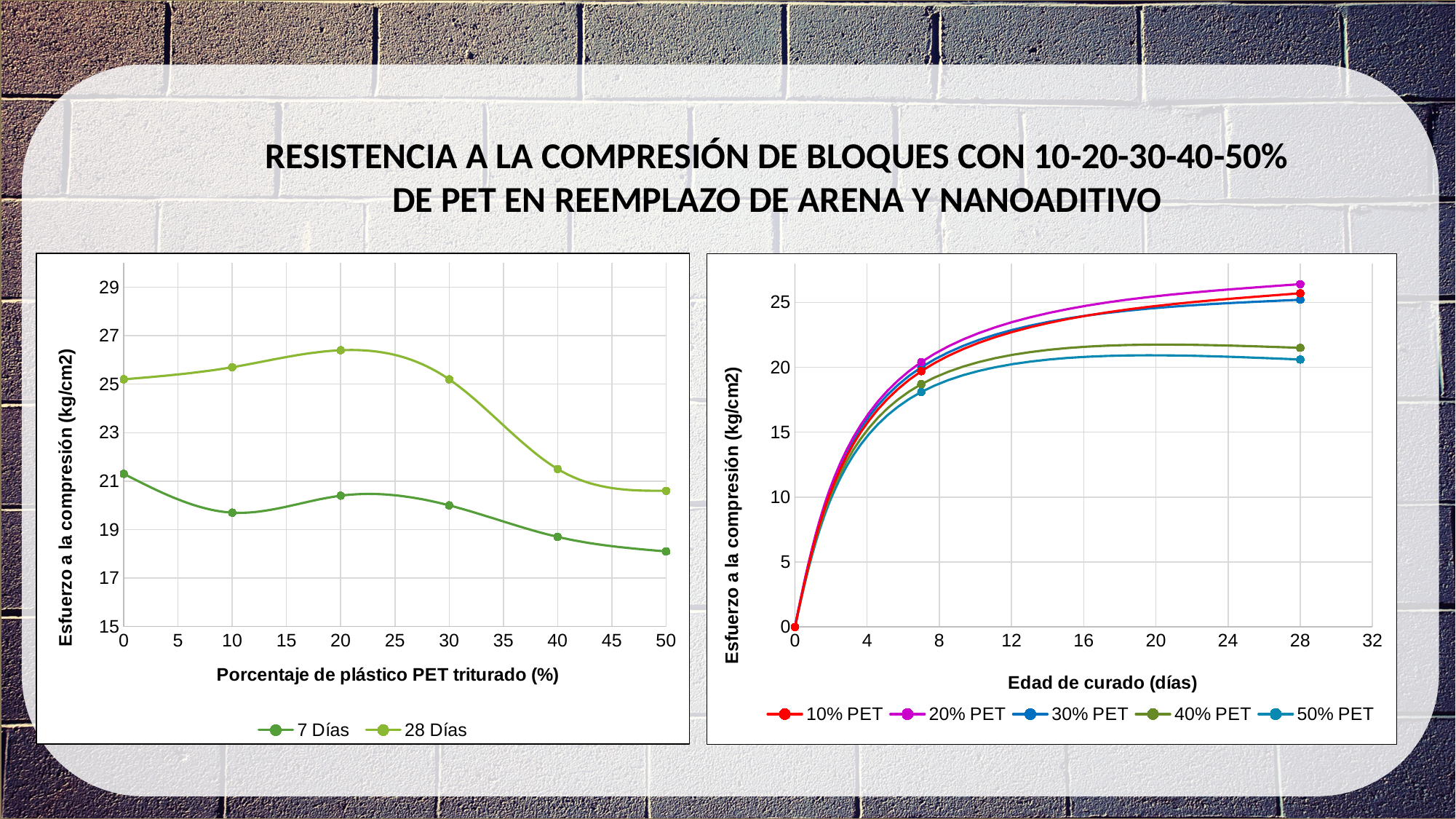
How many series does the legend of the right chart list? 5 In the left chart, which series has the larger value at 30% PET, 7 Días or 28 Días? 28 Días How many series does the legend of the left chart list? 2 In the right chart, which series has the lowest value at 28 days of curing? 50% PET In the left chart, is the 7 Días value at 0% PET greater or less than 21? greater In the left chart, at which percentage of PET is the 28 Días value highest? 20 In the right chart, do the values for 10% PET rise or fall as the curing age increases from 0 to 28 days? rise In the left chart, is the 28 Días value at 40% PET greater or less than 23? less What kind of chart is the left chart on the slide? line chart In the right chart, which series has the highest value at 28 days of curing? 20% PET In the left chart, at which percentage of PET is the 7 Días value lowest? 50 In the left chart, how many data points are plotted for the 28 Días series? 6